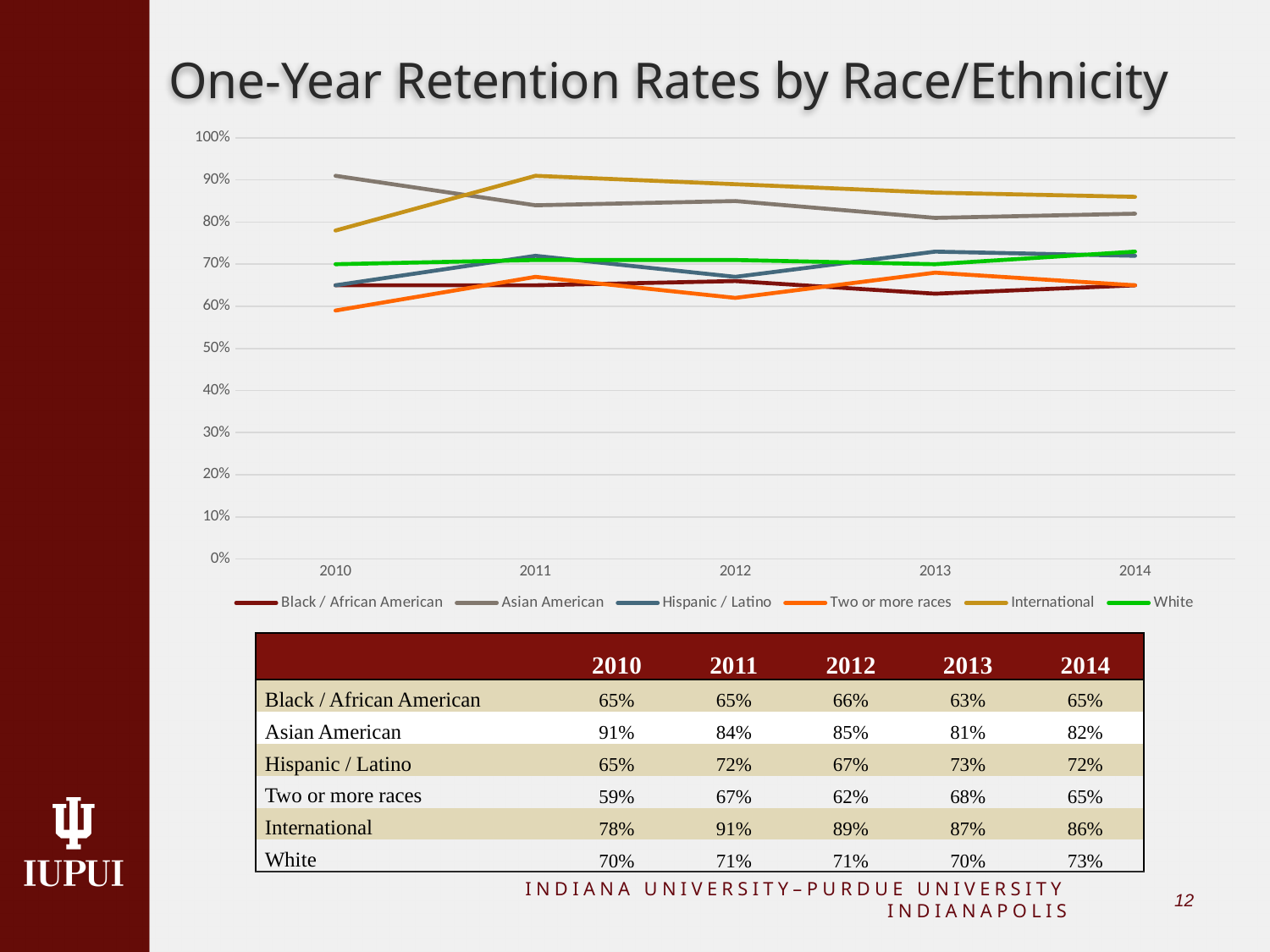
What was the one-year retention rate for International students in 2011? 91% Which group had the lowest one-year retention rate in 2010? Two or more races What was the one-year retention rate for Asian American students in 2010? 91% What is the difference between the International and Black / African American retention rates in 2013? 24% How many years are plotted along the x axis? 5 What type of chart is shown on the slide? line chart Which group had the highest one-year retention rate in 2014? International Which was higher in 2010, the retention rate for Asian American students or for International students? Asian American Did the retention rate for International students rise or fall from 2011 to 2014? fall How many series does the legend list? 6 What is the title of the chart? One-Year Retention Rates by Race/Ethnicity What was the one-year retention rate for Two or more races in 2012? 62%